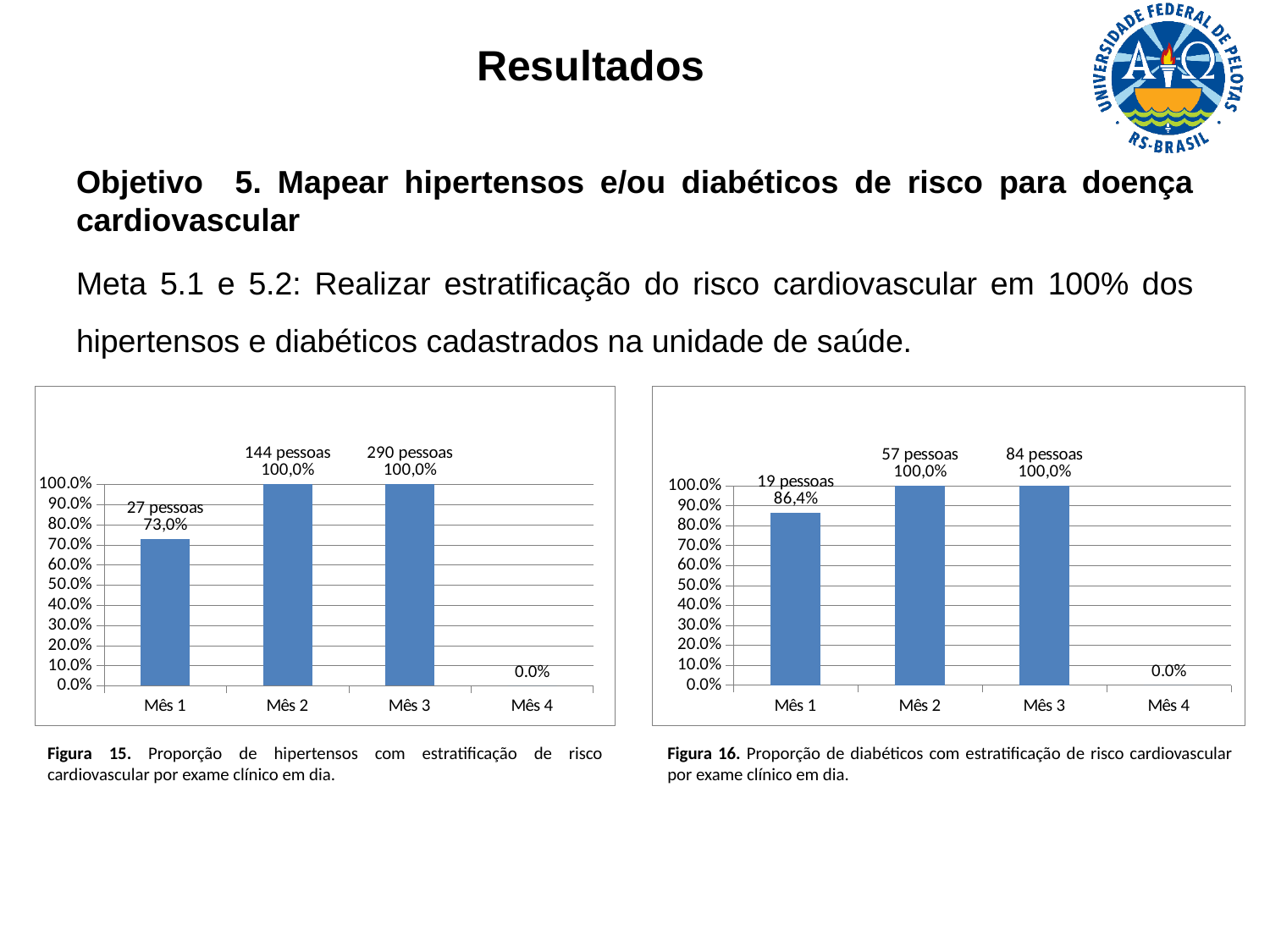
In the right chart (Figura 16, diabéticos), what is the value for Mês 1? 86,4% In the left chart (Figura 15, hipertensos), what is the value for Mês 4? 0.0% In the right chart (Figura 16, diabéticos), is the value for Mês 1 greater or less than 80.0%? greater Which is larger: the Mês 1 value in the left chart (Figura 15) or the Mês 1 value in the right chart (Figura 16)? Right chart (Figura 16), 86,4% In the left chart (Figura 15, hipertensos), how many people does the Mês 3 label report? 290 pessoas In the right chart (Figura 16, diabéticos), how many people does the Mês 2 label report? 57 pessoas How many month categories are shown on the x axis of the left chart (Figura 15)? 4 In the left chart (Figura 15, hipertensos), what is the value for Mês 1? 73,0% In the left chart (Figura 15, hipertensos), what is the difference between the Mês 2 value and the Mês 1 value? 27,0% What kind of chart is the right chart (Figura 16)? Bar chart In the left chart (Figura 15, hipertensos), which month has the lowest value? Mês 4 In the right chart (Figura 16, diabéticos), what is the difference between the Mês 2 value and the Mês 1 value? 13,6%